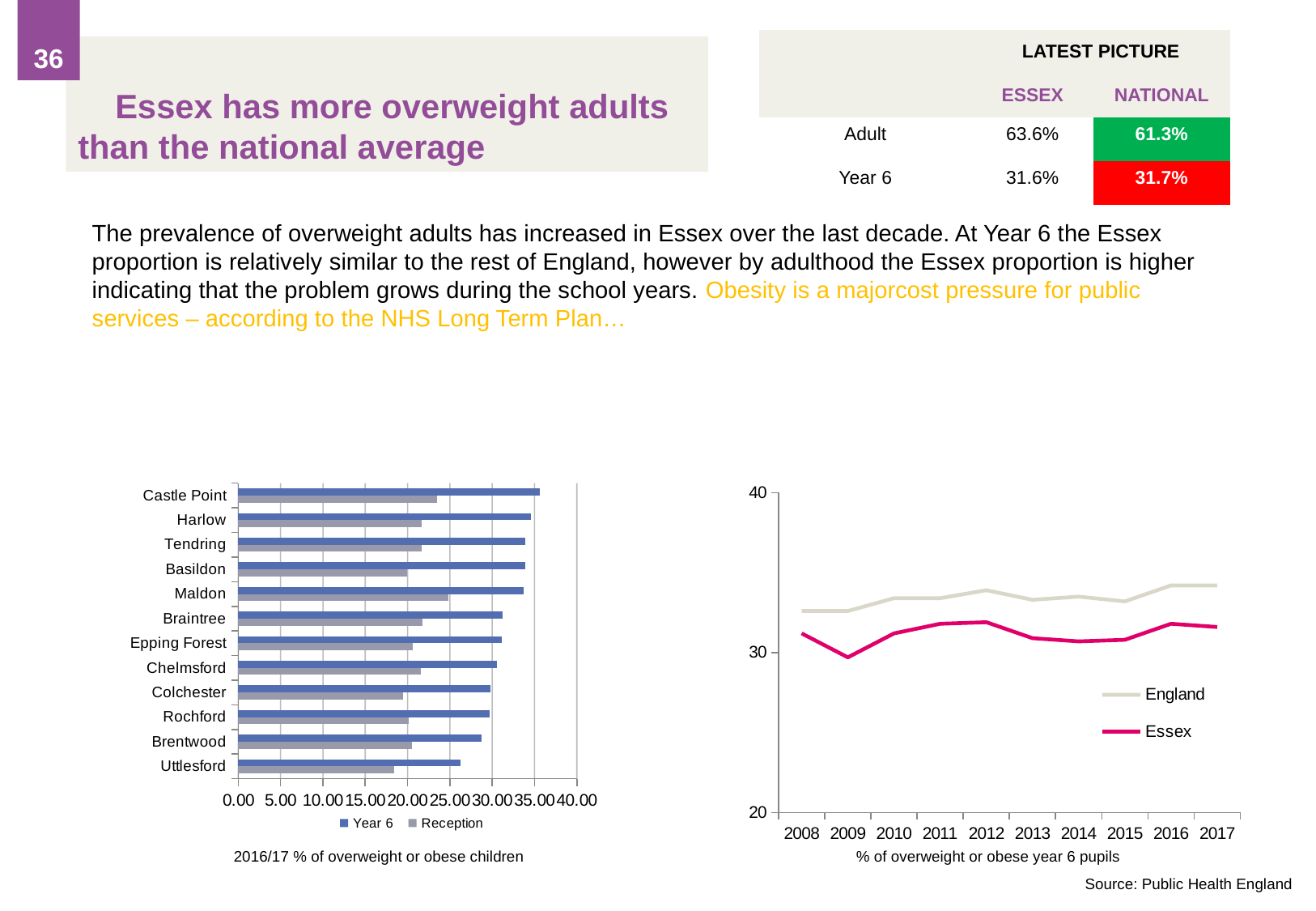
What kind of chart is the chart on the left of the slide (2016/17 % of overweight or obese children)? bar chart In the left bar chart, which district has the lowest Year 6 value? Uttlesford In the left bar chart, is the Reception value for Uttlesford greater or less than 20.00? less In the right line chart, in 2012, which is higher: England or Essex? England In the right line chart, how many series does the legend list? 2 In the left bar chart, which district has the highest Year 6 value? Castle Point In the left bar chart, how many series does the legend list? 2 In the left bar chart, for Castle Point, which is larger: the Year 6 value or the Reception value? Year 6 In the left bar chart, is the Year 6 value for Uttlesford greater or less than 30.00? less In the left bar chart, how many districts are listed on the vertical axis? 12 In the right line chart, in which year is the Essex value lowest? 2009 What kind of chart is the chart on the right of the slide (% of overweight or obese year 6 pupils)? line chart